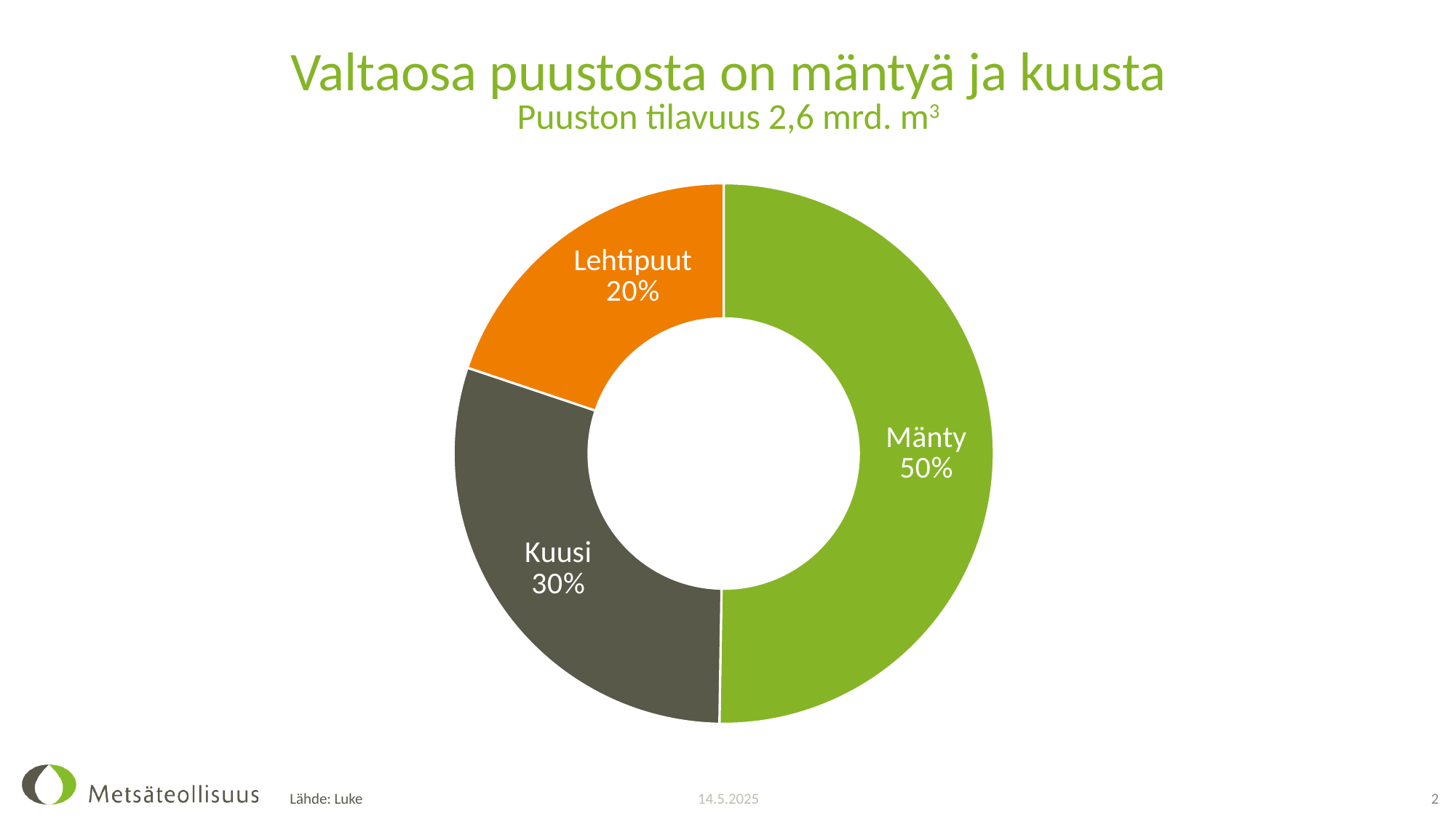
What share of the chart does Kuusi represent? 30% Which has a larger share, Kuusi or Lehtipuut? Kuusi What is the title of the slide? Valtaosa puustosta on mäntyä ja kuusta What is the difference in percentage points between the shares of Mänty and Kuusi? 20 Which category has the smallest share in the chart? Lehtipuut Which category has the largest share in the chart? Mänty What share of the chart does Mänty represent? 50% How many categories are shown in the chart? 3 What share of the chart does Lehtipuut represent? 20% What colour is the Lehtipuut slice? Orange What is the difference in percentage points between the shares of Kuusi and Lehtipuut? 10 What kind of chart is shown on the slide? Pie chart (doughnut)